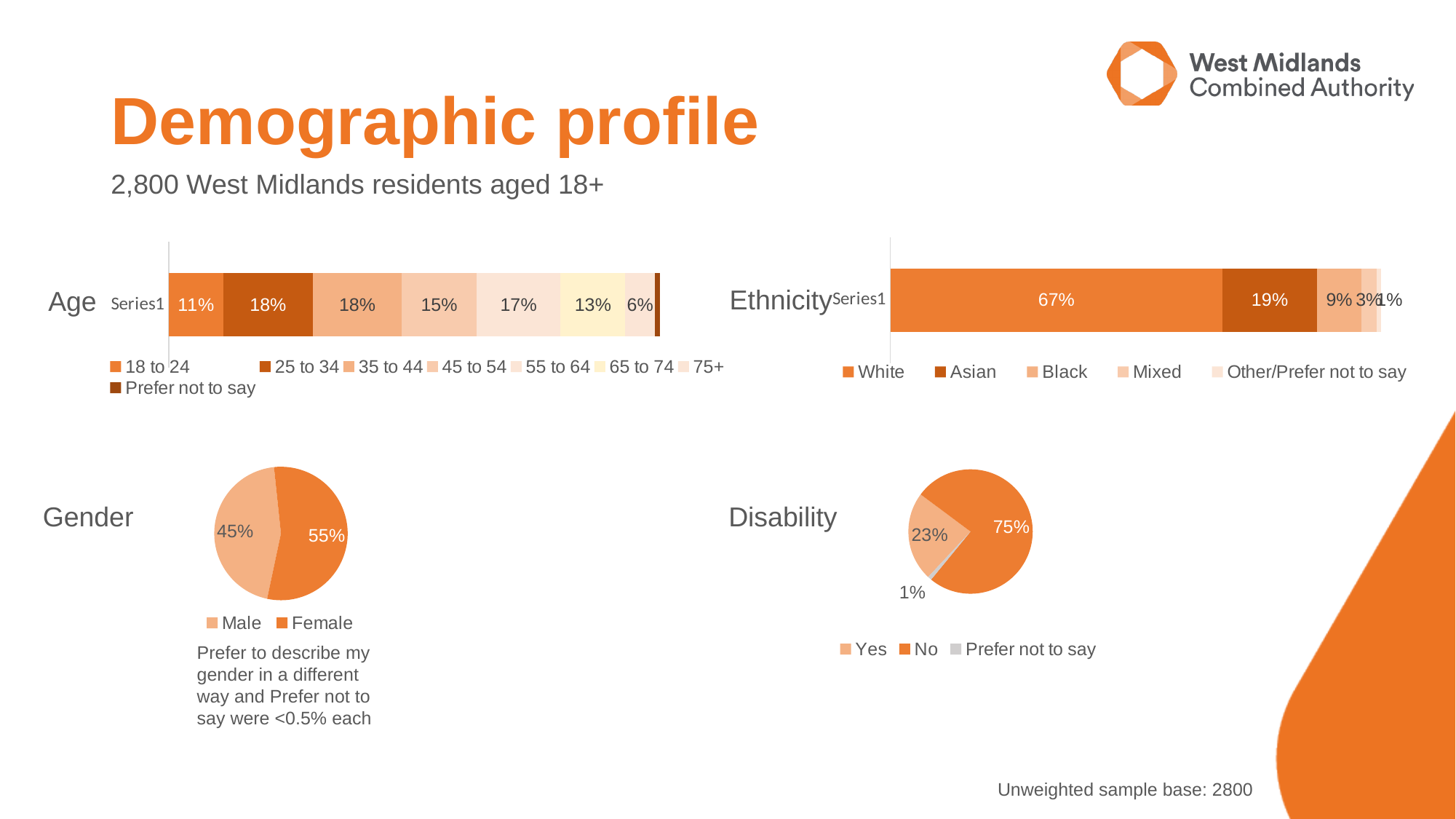
In the Age chart, what percentage of residents are aged 75+? 6% In the Gender chart, what share of the pie is Male? 45% In the Age chart, how many entries does the legend list? 8 In the Ethnicity chart, what is the difference between the Asian share and the Black share? 10% In the Disability chart, what percentage answered No? 75% In the Age chart, what percentage of residents are aged 18 to 24? 11% In the Ethnicity chart, which ethnic group has the lowest share? Other/Prefer not to say In the Ethnicity chart, what percentage of residents are White? 67% In the Gender chart, which is larger, Male or Female? Female In the Age chart, what is the difference between the 55 to 64 share and the 65 to 74 share? 4% What kind of chart is the Ethnicity chart? Stacked bar chart In the Disability chart, how many categories does the legend list? 3